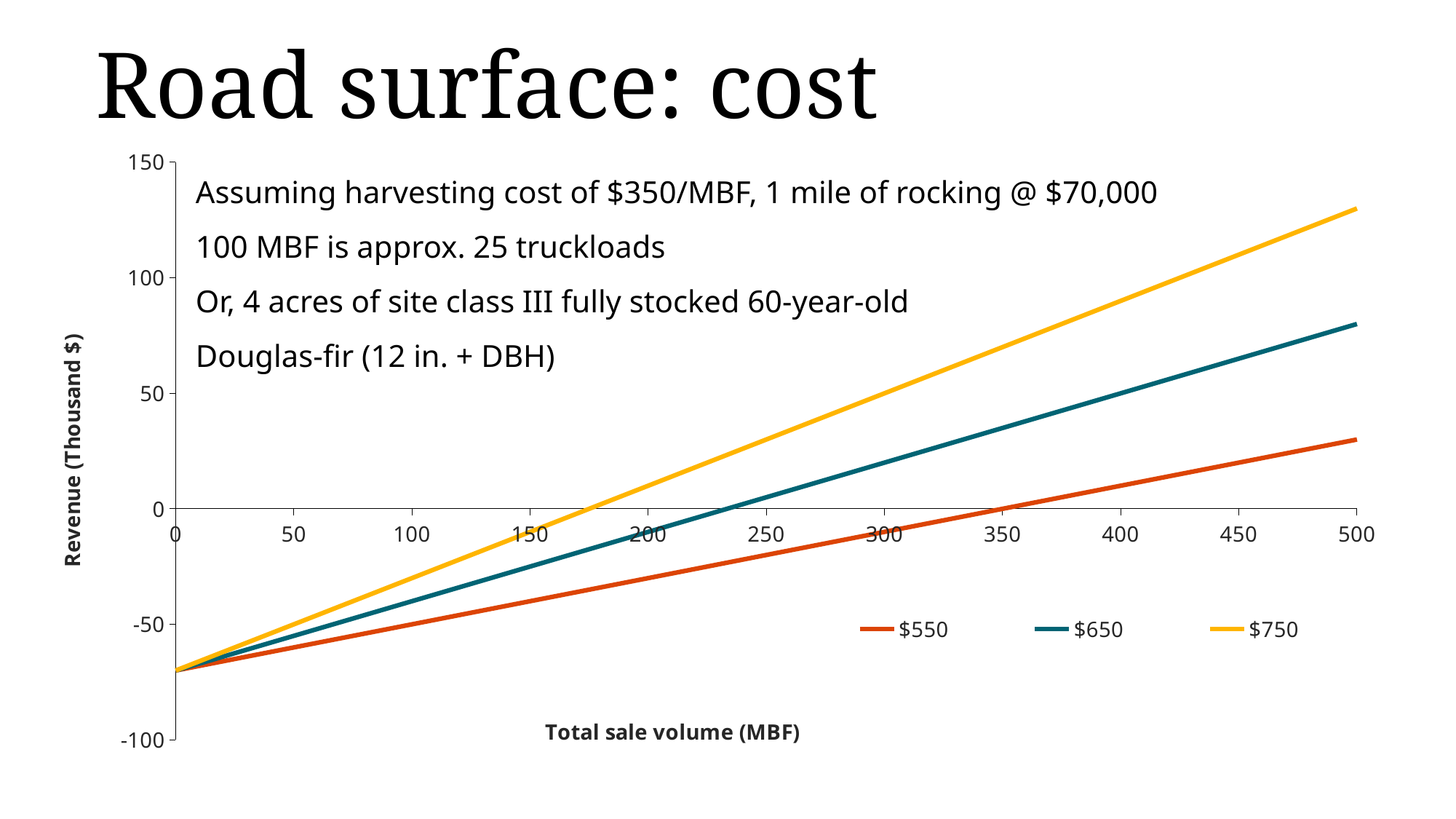
Is the revenue for the $550 series at 500 MBF greater or less than 50? less What is the title of the vertical axis? Revenue (Thousand $) How many series does the legend list? 3 Is the revenue for the $650 series at 0 MBF greater or less than -50? less Is the revenue for the $650 series at 500 MBF greater or less than 50? greater At 500 MBF, which series has the larger revenue, $750 or $550? $750 Which series has the lowest revenue at 500 MBF? $550 What kind of chart is shown on the slide? line chart What are the three series named in the legend? $550, $650, $750 Which series has the highest revenue at 500 MBF? $750 Do the revenue lines rise or fall as total sale volume increases? rise